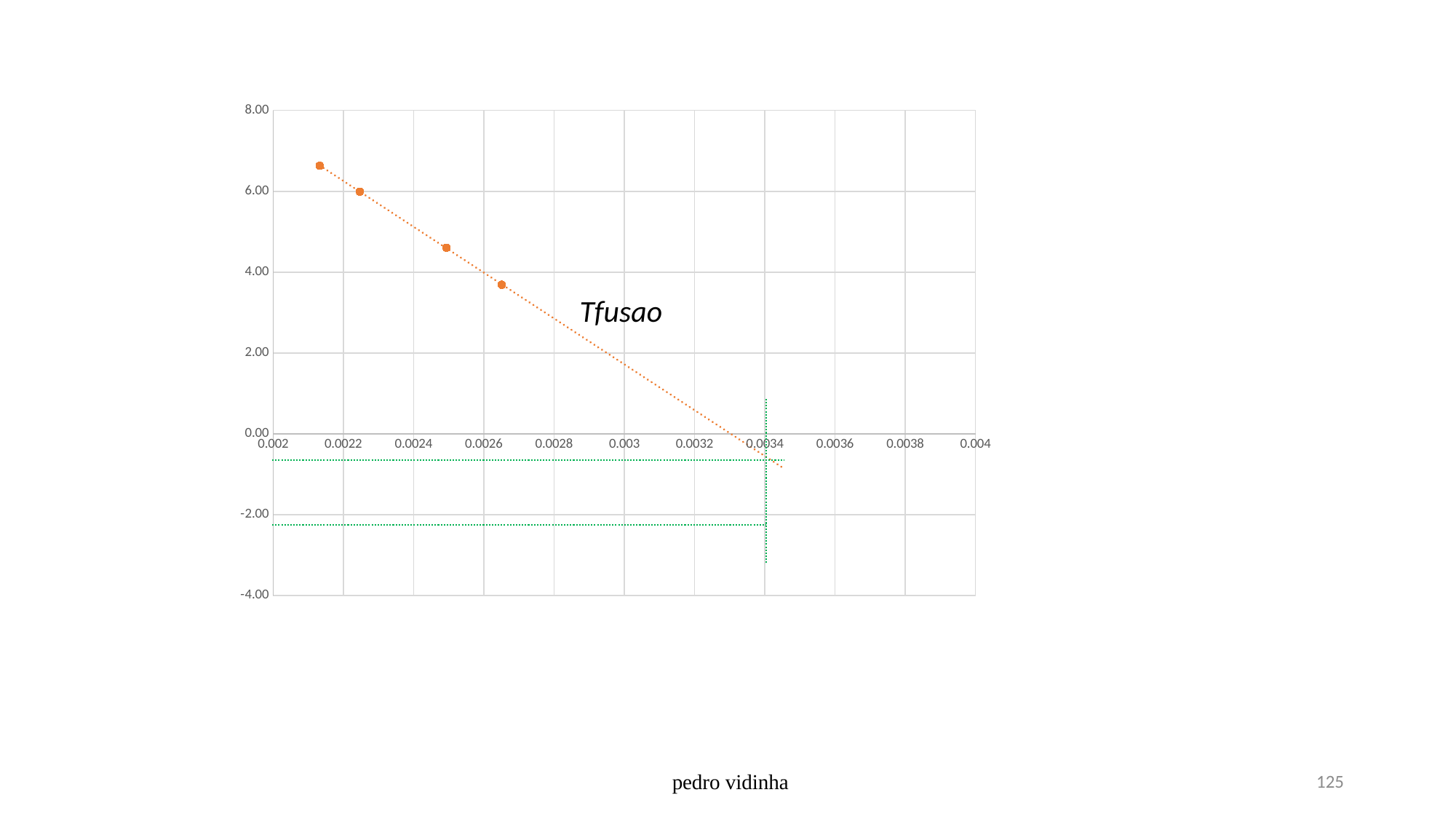
Which data point has the highest y value, the leftmost or the rightmost? leftmost Is the y value of the third data point from the left greater or less than 4.00? greater Is the y value of the rightmost data point greater or less than 4.00? less How many data points are plotted on the chart? 4 What is the lowest value shown on the y axis? -4.00 Is the x value of the leftmost data point greater or less than 0.0022? less What kind of chart is shown on the slide? scatter chart What text label is written next to the dotted trendline on the chart? Tfusao Do the plotted values rise or fall as the x value increases? fall